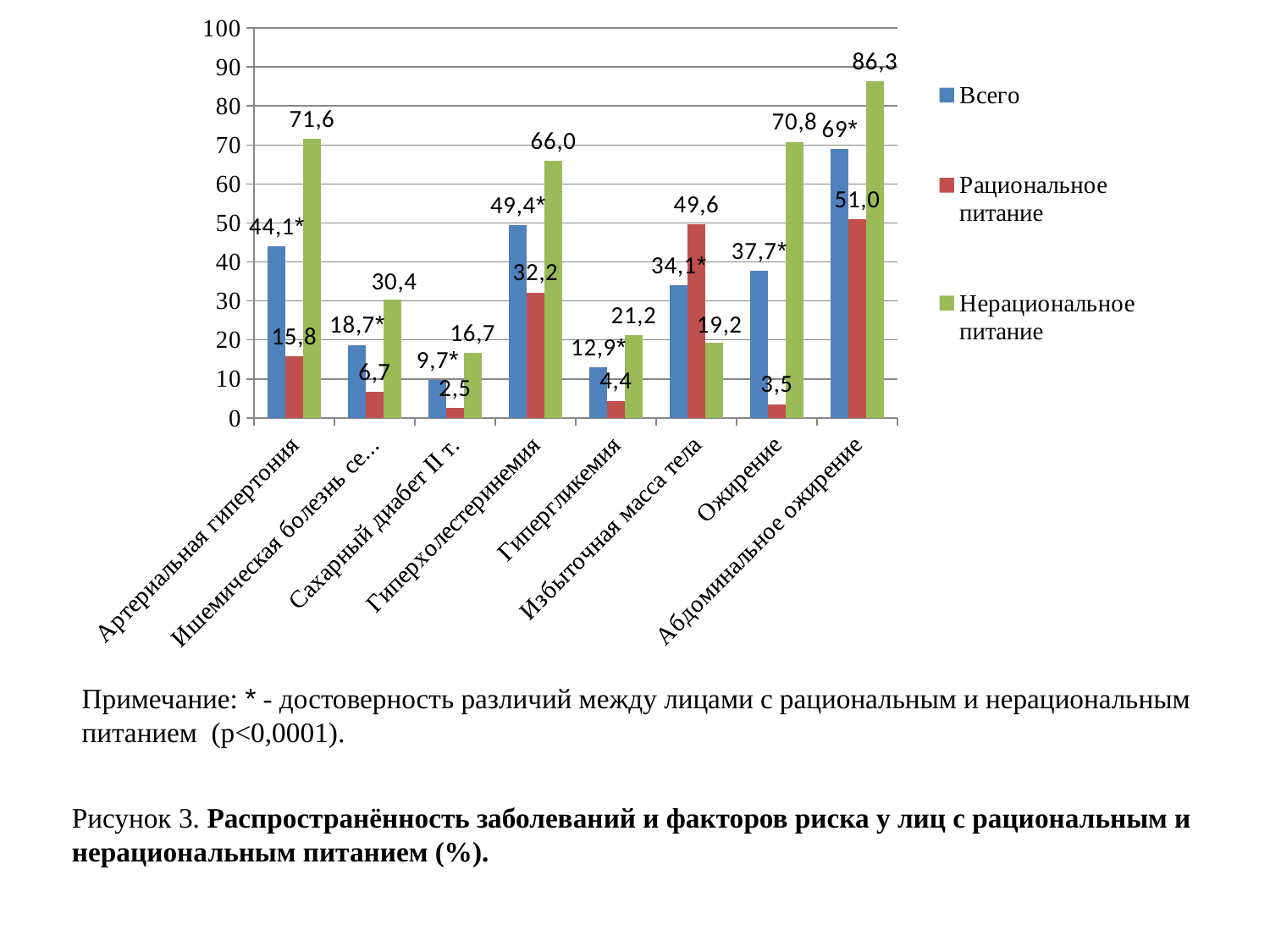
How many series does the legend list? 3 How many categories are shown on the x axis? 8 Is the value for Нерациональное питание in the Абдоминальное ожирение category greater or less than 80? greater What is the difference between the Нерациональное питание and Рациональное питание values in the Ожирение category? 67,3 What is the value for Нерациональное питание in the Артериальная гипертония category? 71,6 What is the value for Рациональное питание in the Гиперхолестеринемия category? 32,2 Which category has the highest value for Нерациональное питание? Абдоминальное ожирение Which category has the lowest value for Рациональное питание? Сахарный диабет II т. What kind of chart is shown on the slide? bar chart What is the value for Всего in the Ожирение category, as printed on the slide? 37,7* In the Избыточная масса тела category, which is larger: Рациональное питание or Нерациональное питание? Рациональное питание What colour are the bars for the Всего series? blue